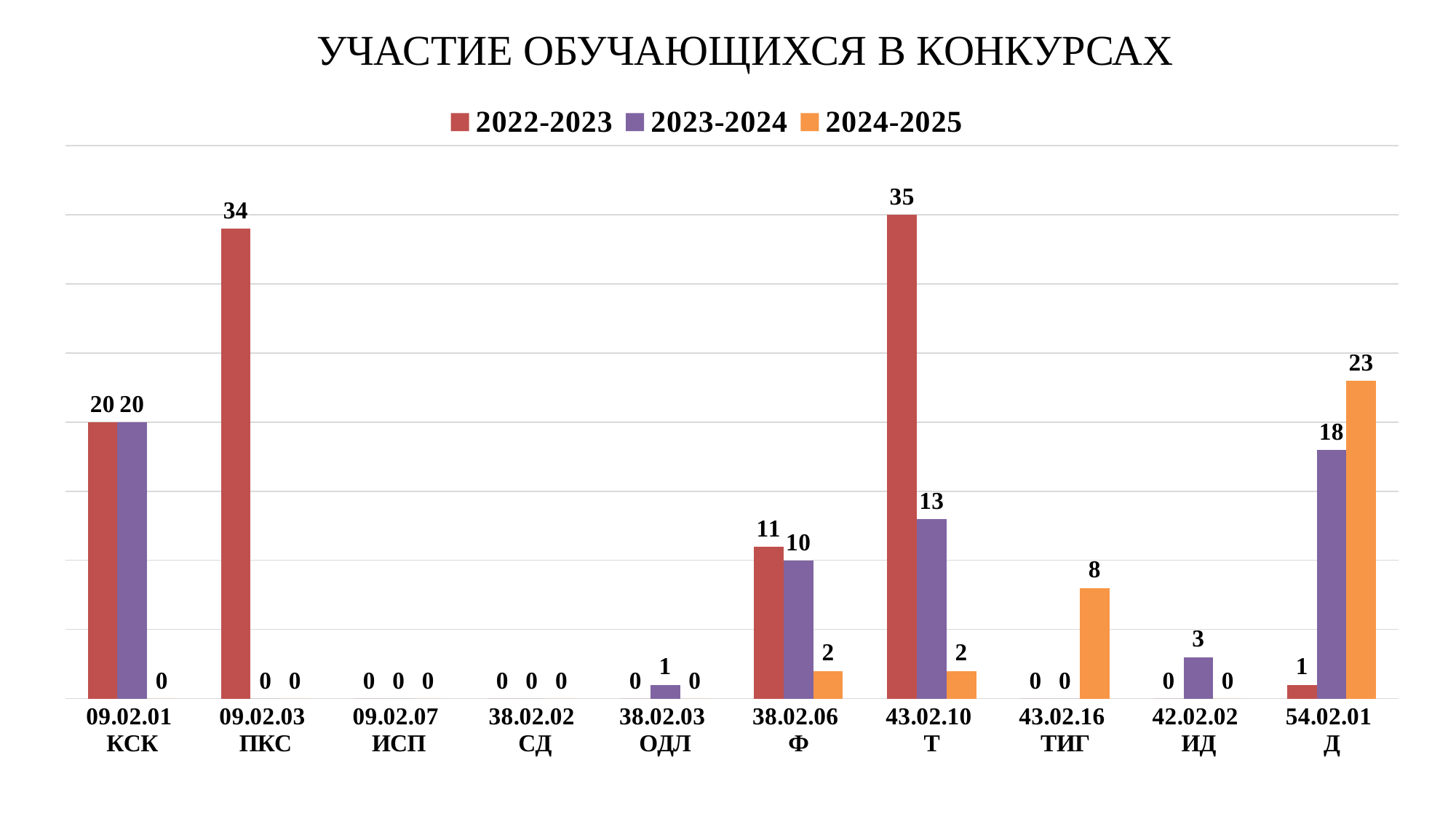
What is the difference between the 2022-2023 values for 43.02.10 Т and 09.02.03 ПКС? 1 How many series does the legend list? 3 What is the value for 38.02.06 Ф in the 2023-2024 series? 10 Which category has the highest value in the 2022-2023 series? 43.02.10 Т What is the value for 54.02.01 Д in the 2024-2025 series? 23 What is the difference between the 2024-2025 and 2023-2024 values for 54.02.01 Д? 5 What is the title of the chart? УЧАСТИЕ ОБУЧАЮЩИХСЯ В КОНКУРСАХ Which category has the highest value in the 2024-2025 series? 54.02.01 Д What is the value for 43.02.10 Т in the 2022-2023 series? 35 What kind of chart is shown on the slide? Bar chart Which is larger for 43.02.16 ТИГ: the 2024-2025 value or the 2023-2024 value? 2024-2025 How many categories are shown on the x axis? 10